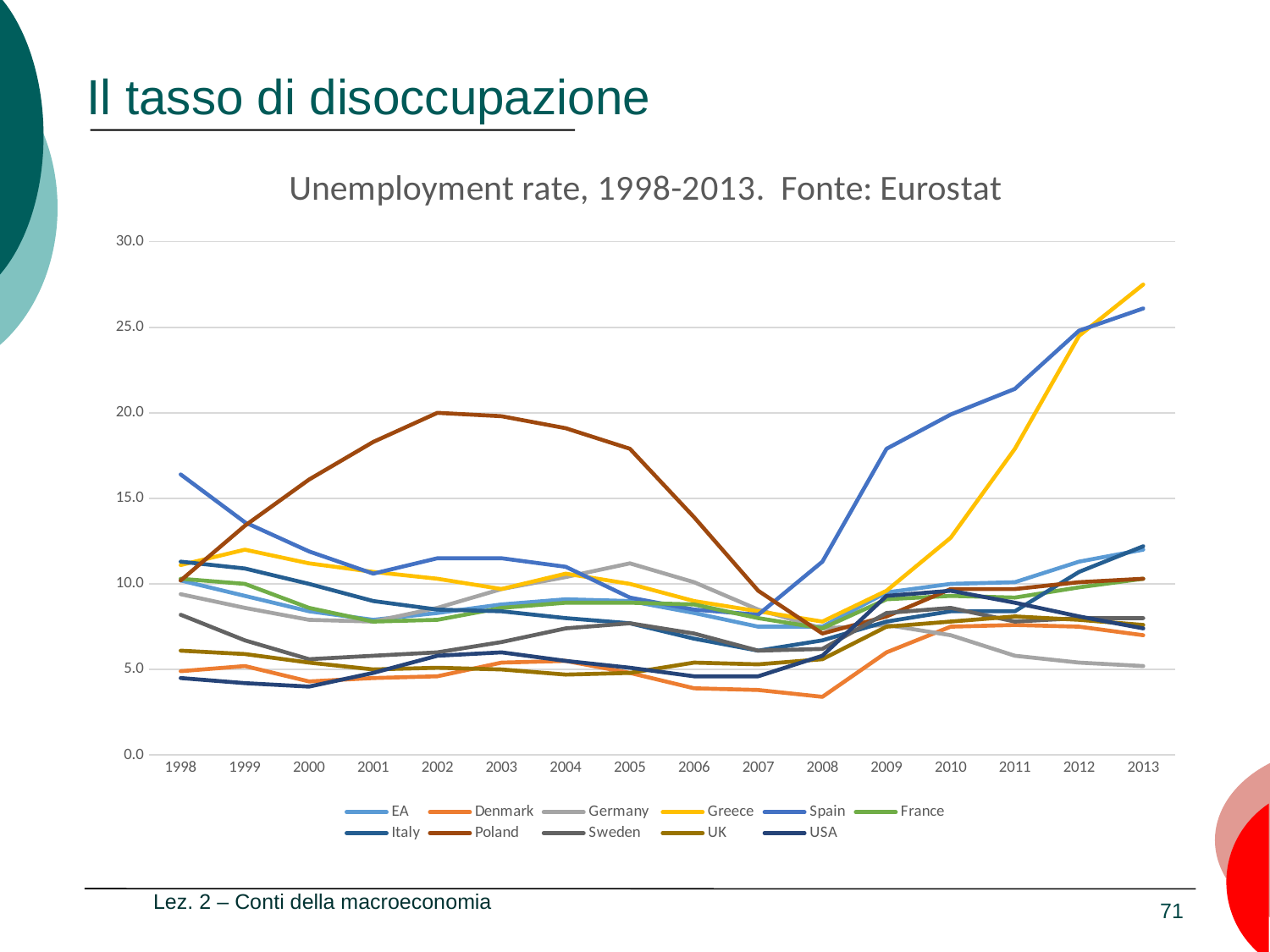
What is the title of the chart? Unemployment rate, 1998-2013. Fonte: Eurostat Which country has the highest unemployment rate in 2013? Greece In 2009, which is larger, the unemployment rate of Spain or of Greece? Spain Which country has the highest unemployment rate in 1998? Spain Which country has the lowest unemployment rate in 2008? Denmark Which country has the highest unemployment rate in 2002? Poland Is the unemployment rate for Denmark in 2008 greater or less than 5.0? less Is the unemployment rate for Spain in 2013 greater or less than 25.0? greater What kind of chart is shown on the slide? line chart Does the unemployment rate for Greece rise or fall from 2008 to 2013? rise How many series does the legend list? 11 How many years are plotted along the x axis? 16